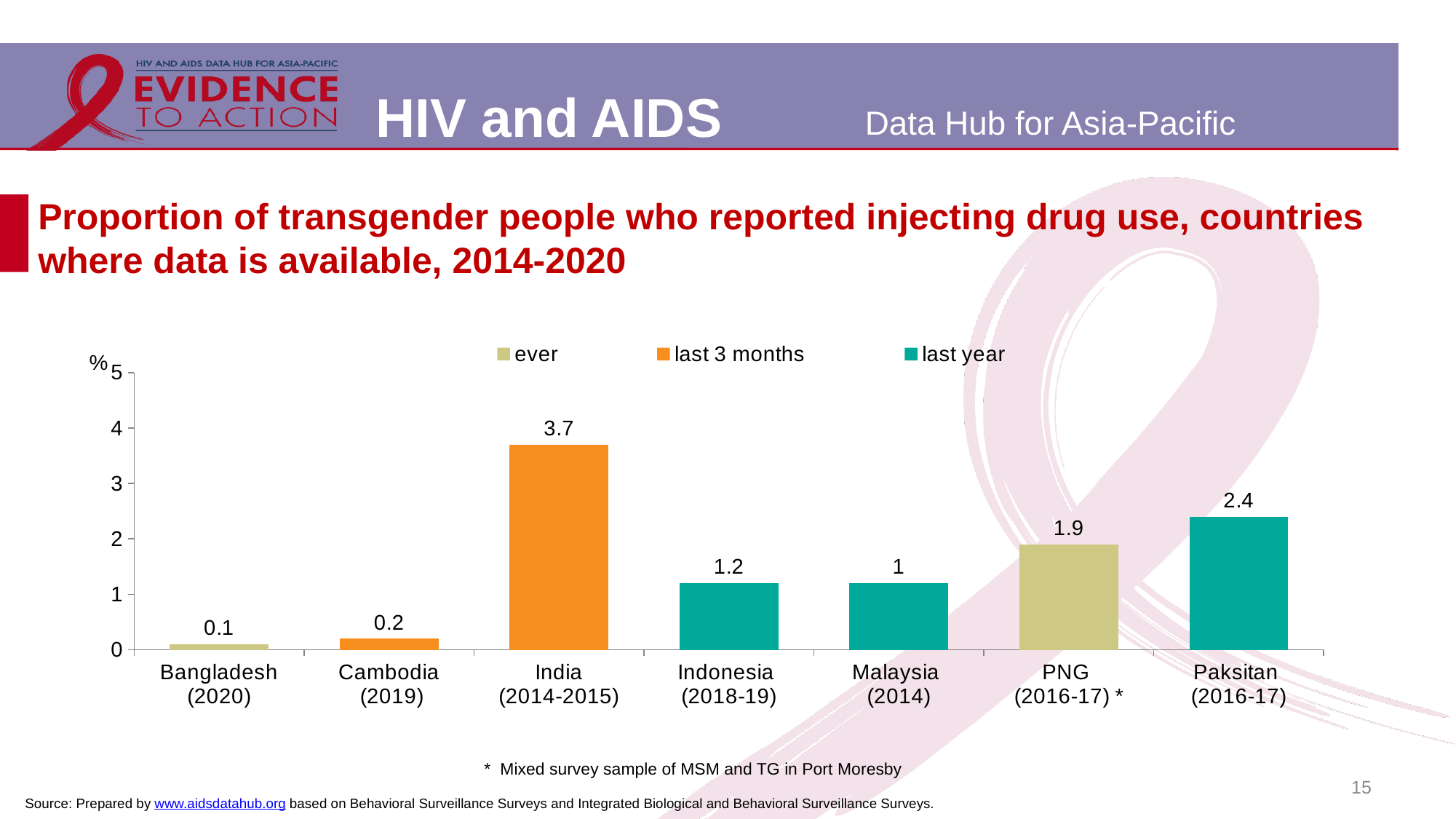
Which legend series does the bar for Cambodia (2019) belong to? last 3 months Is the value for Pakistan (2016-17) greater or less than 2? greater What is the value for PNG (2016-17)? 1.9 Which country has the lowest value? Bangladesh (2020) What kind of chart is shown? bar chart Which country has the highest value? India (2014-2015) How many countries are shown on the chart? 7 How many series does the legend list? 3 What is the value for Bangladesh (2020)? 0.1 What is the difference between the values for India (2014-2015) and Pakistan (2016-17)? 1.3 What is the value for India (2014-2015)? 3.7